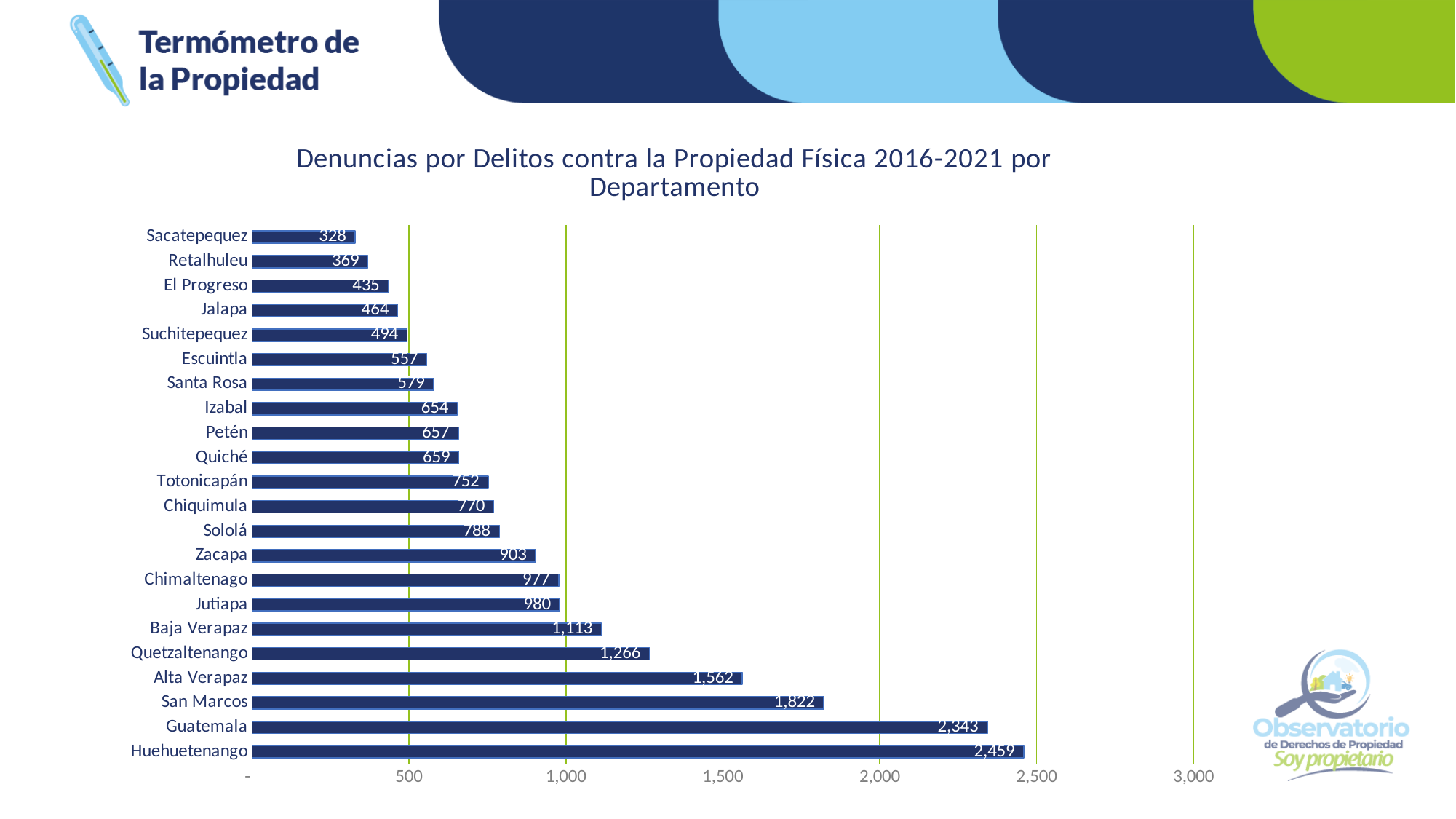
What is the difference between the values for San Marcos and Alta Verapaz? 260 What is the title of the chart? Denuncias por Delitos contra la Propiedad Física 2016-2021 por Departamento Is the value for Baja Verapaz greater or less than 1,000? greater What is the value for Quetzaltenango? 1,266 What is the value for Huehuetenango? 2,459 Which department has the highest value? Huehuetenango Which department has the lowest value? Sacatepequez What kind of chart is shown on the slide? bar chart Which is larger, the value for Zacapa or the value for Sololá? Zacapa What is the difference between the values for Huehuetenango and Guatemala? 116 What is the value for Sacatepequez? 328 How many departments are shown in the chart? 22